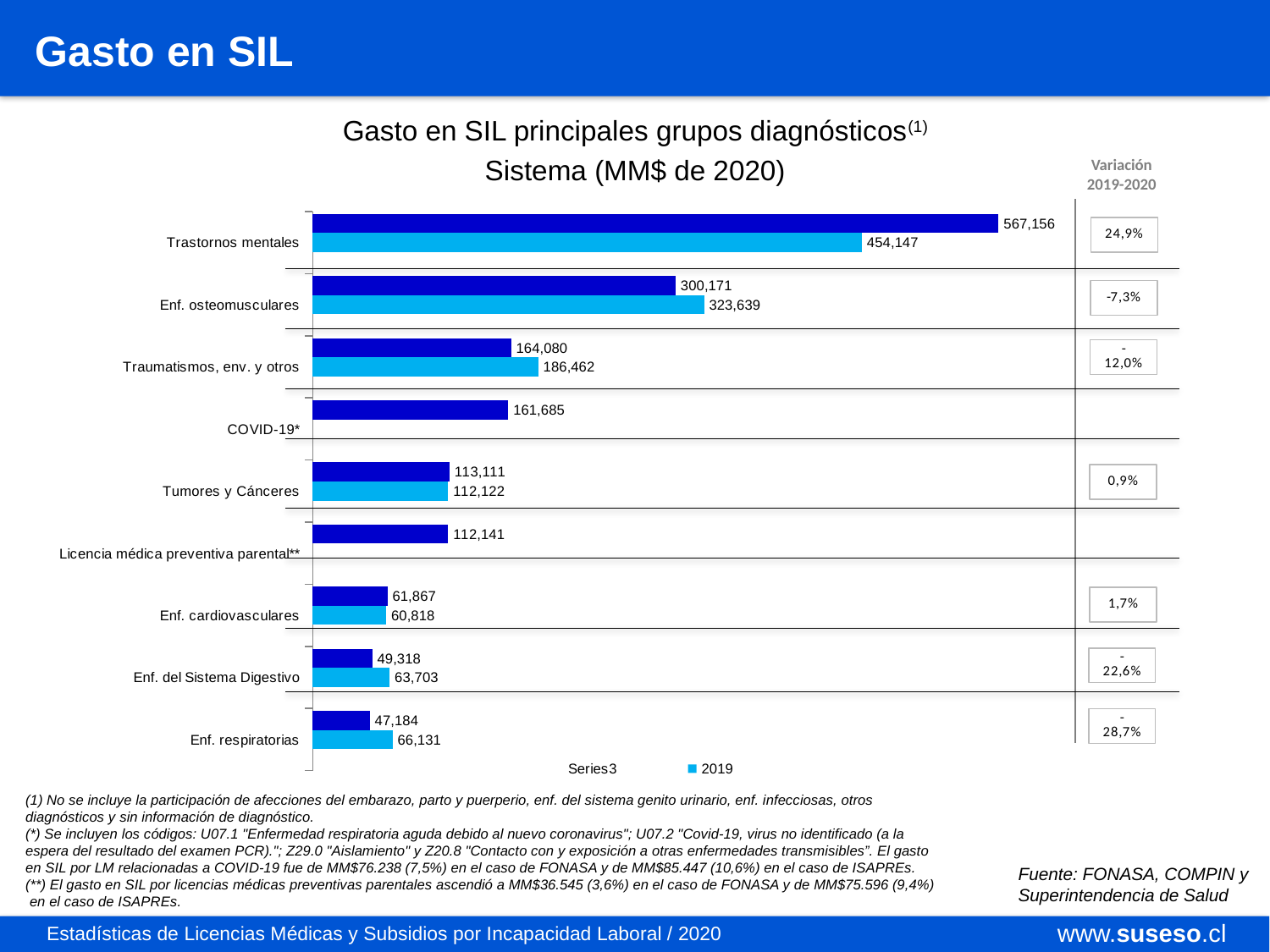
What type of chart is shown on the slide? Bar chart What is the difference between the dark blue (Series3) and 2019 values for Trastornos mentales? 113,009 What is the value of the dark blue (Series3) bar for Licencia médica preventiva parental**? 112,141 For Enf. del Sistema Digestivo, which is larger: the dark blue (Series3) value or the 2019 value? 2019 How many diagnostic group categories are shown on the chart? 9 What is the value of the dark blue (Series3) bar for COVID-19*? 161,685 How many series does the legend list? 2 Which category has the lowest 2019 value? Enf. cardiovasculares What is the difference between the 2019 and dark blue (Series3) values for Enf. respiratorias? 18,947 Which category has the highest value in the dark blue (Series3) series? Trastornos mentales What is the 2019 value for Enf. osteomusculares? 323,639 What is the 2019 value for Trastornos mentales? 454,147